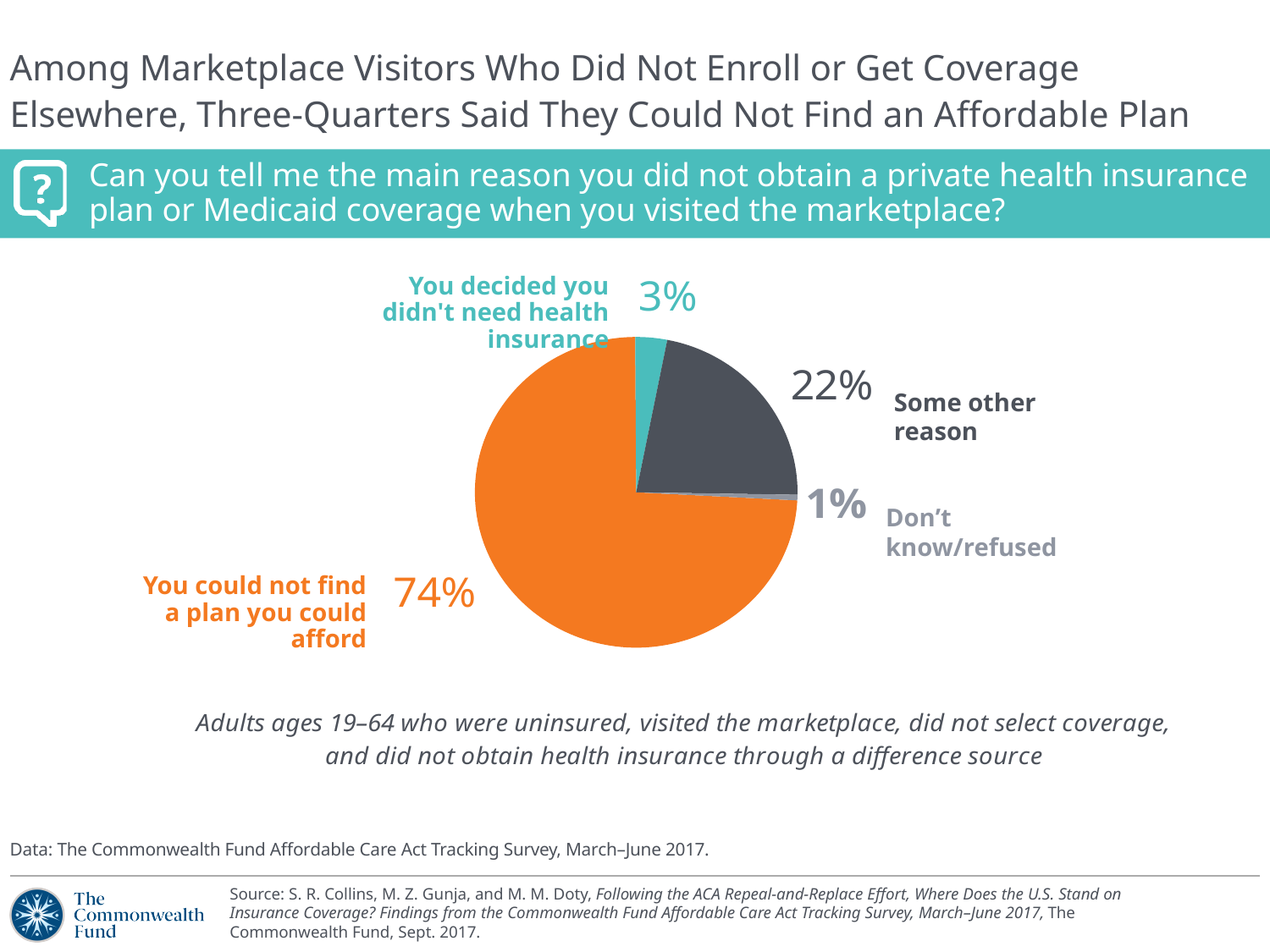
What share of respondents said they decided they didn't need health insurance? 3% Which reason has the smallest share of the pie? Don't know/refused What is the combined share of 'You decided you didn't need health insurance' and 'Don't know/refused'? 4% What share of respondents gave some other reason? 22% What kind of chart is shown on the slide? Pie chart Which is larger: the share for 'Some other reason' or the share for 'You decided you didn't need health insurance'? Some other reason How many slices does the pie chart have? 4 What share of respondents said they could not find a plan they could afford? 74% Which reason has the largest share of the pie? You could not find a plan you could afford What colour is the slice for 'You could not find a plan you could afford'? Orange What is the difference in percentage points between 'You could not find a plan you could afford' and 'Some other reason'? 52 percentage points What share of respondents answered don't know/refused? 1%